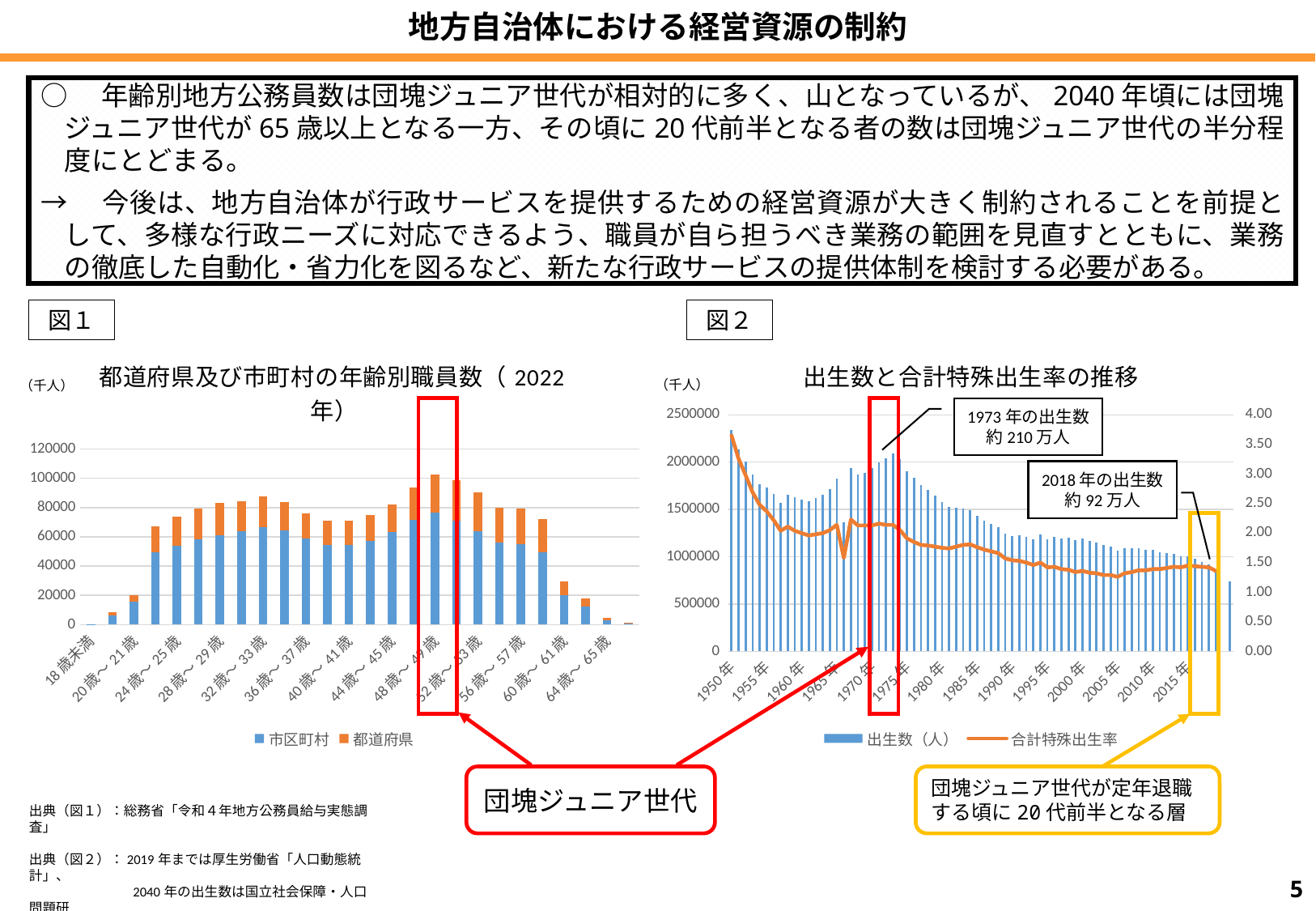
How many series does the legend of 図1 list? 2 In 図2, what was the number of births in 1973 according to the annotation? 約210万人 In 図2, do the births (出生数) generally rise or fall from 1975年 to 2015年? fall What kind of chart is 図1 (都道府県及び市町村の年齢別職員数)? Stacked bar chart What are the two legend entries in 図1? 市区町村 and 都道府県 In 図1, is the total value for 20歳～21歳 greater or less than 40000? less In 図2, is the number of births in 1950年 greater or less than 2000000? greater In 図2, what was the number of births in 2018 according to the annotation? 約92万人 In 図1, which is larger, the total for 28歳～29歳 or the total for 60歳～61歳? 28歳～29歳 In 図1, is the total value for 64歳～65歳 greater or less than 20000? less How many series does the legend of 図2 list? 2